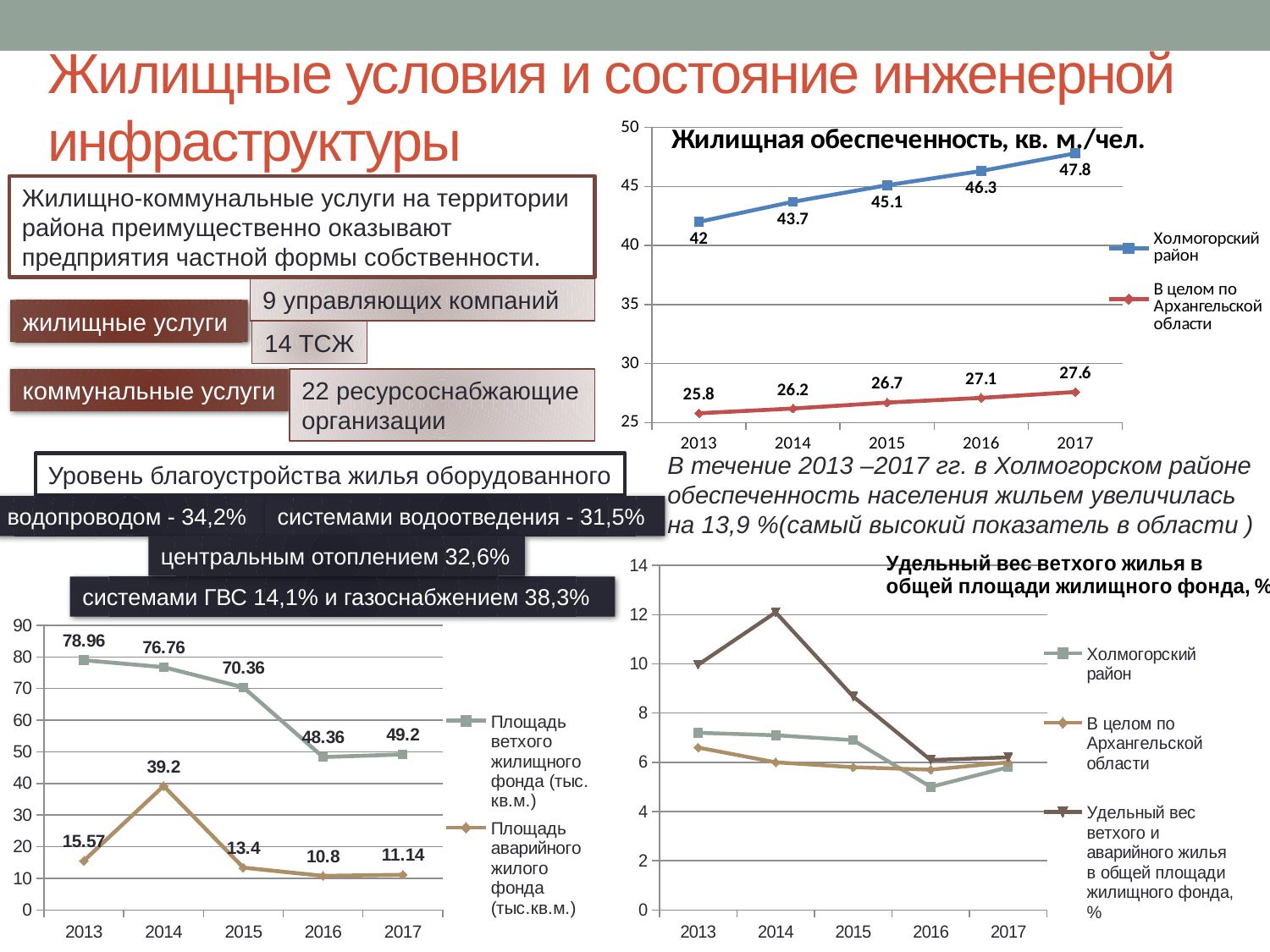
On the bottom-left chart, what kind of chart is it? line chart On the chart titled 'Удельный вес ветхого жилья в общей площади жилищного фонда, %', is the 2014 value for Удельный вес ветхого и аварийного жилья greater or less than 10? greater On the chart titled 'Жилищная обеспеченность, кв. м./чел.', what is the value for В целом по Архангельской области in 2013? 25.8 On the chart titled 'Жилищная обеспеченность, кв. м./чел.', do the values for Холмогорский район rise or fall from 2013 to 2017? rise On the bottom-left chart, in which year is Площадь аварийного жилого фонда highest? 2014 On the bottom-left chart, what is the difference between Площадь ветхого жилищного фонда and Площадь аварийного жилого фонда in 2017? 38.06 On the chart titled 'Жилищная обеспеченность, кв. м./чел.', what is the value for Холмогорский район in 2017? 47.8 On the chart titled 'Удельный вес ветхого жилья в общей площади жилищного фонда, %', how many series does the legend list? 3 On the chart titled 'Жилищная обеспеченность, кв. м./чел.', how many series does the legend list? 2 On the bottom-left chart, what is the value of Площадь ветхого жилищного фонда in 2013? 78.96 On the bottom-left chart, in which year is Площадь ветхого жилищного фонда lowest? 2016 On the chart titled 'Жилищная обеспеченность, кв. м./чел.', what is the difference between the Холмогорский район value and the В целом по Архангельской области value in 2015? 18.4